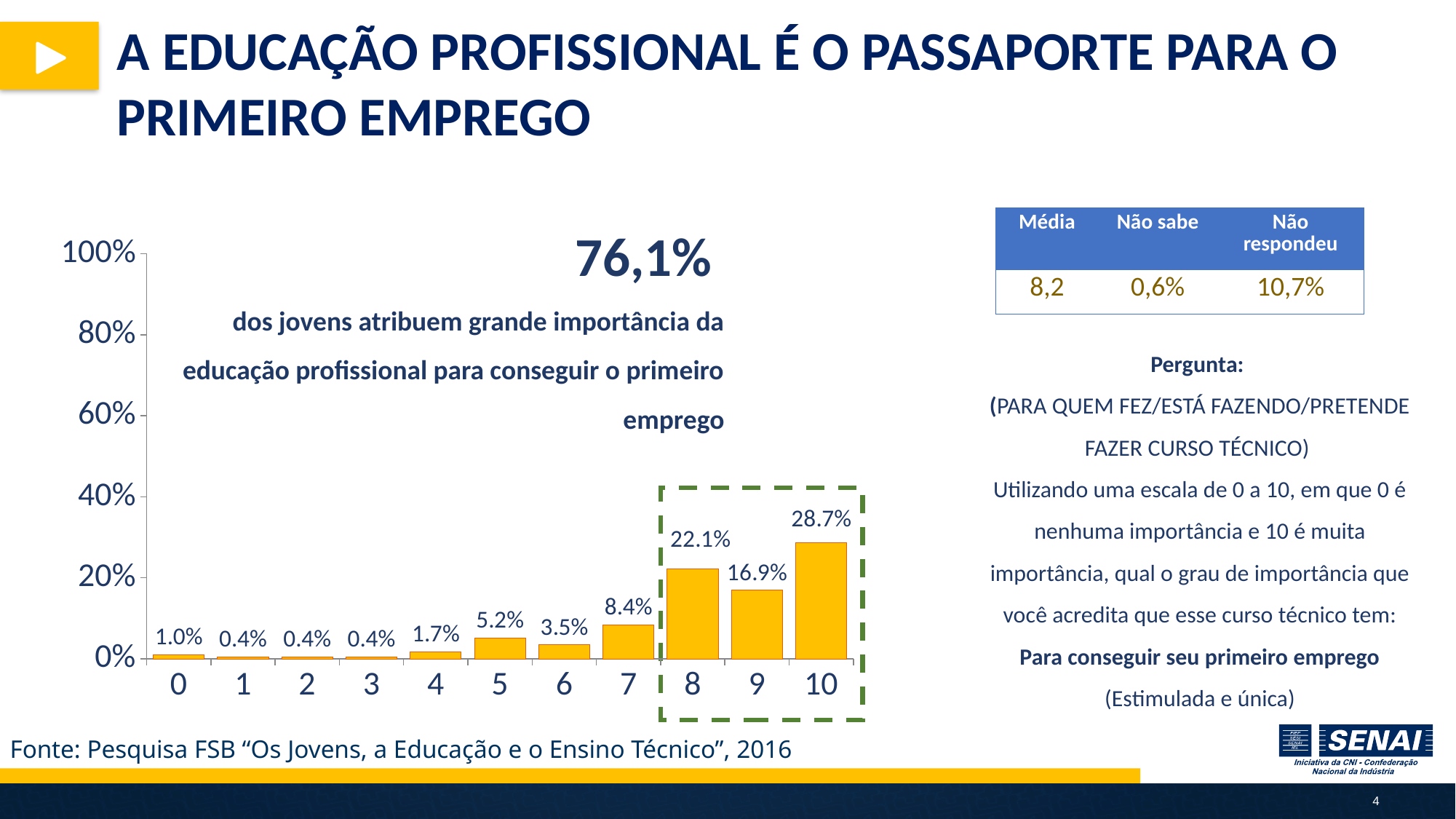
Which is larger, the value for category 8 or the value for category 9? 8 What is the value for category 10? 28.7% What is the total of the values for categories 8, 9 and 10? 67.7% Which category has the lowest value among 0, 4, 5 and 6? 0 Which category has the highest value? 10 What is the difference between the values for category 10 and category 9? 11.8% How many categories are shown on the x axis? 11 What kind of chart is shown on the slide? bar chart What is the value for category 7? 8.4% What is the value for category 8? 22.1% Is the value for category 10 greater or less than 20%? greater What is the value shown for 'Média' in the table? 8,2